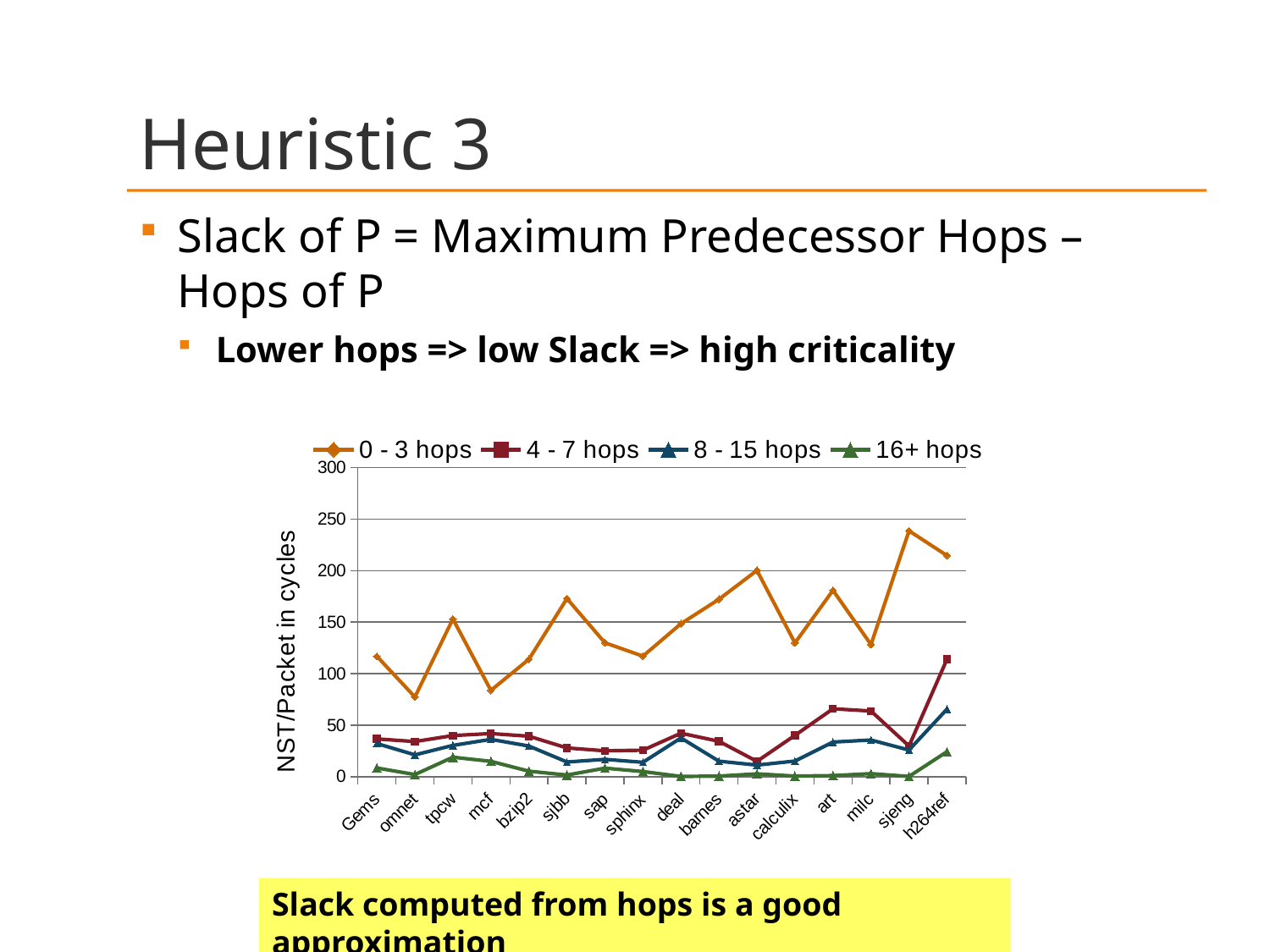
For the 0 - 3 hops series, which benchmark has the larger value, tpcw or mcf? tpcw Which series is plotted with the orange line in the chart? 0 - 3 hops What kind of chart is shown on the slide? line chart How many series does the chart's legend list? 4 What is the label of the vertical axis of the chart? NST/Packet in cycles Is the 0 - 3 hops value for omnet greater or less than 100? less For which benchmark does the 0 - 3 hops series reach its highest value? sjeng Is the 4 - 7 hops value for h264ref greater or less than 100? greater For which benchmark does the 4 - 7 hops series reach its highest value? h264ref How many benchmark categories are plotted along the x axis of the chart? 16 Is the 16+ hops value for tpcw greater or less than 50? less